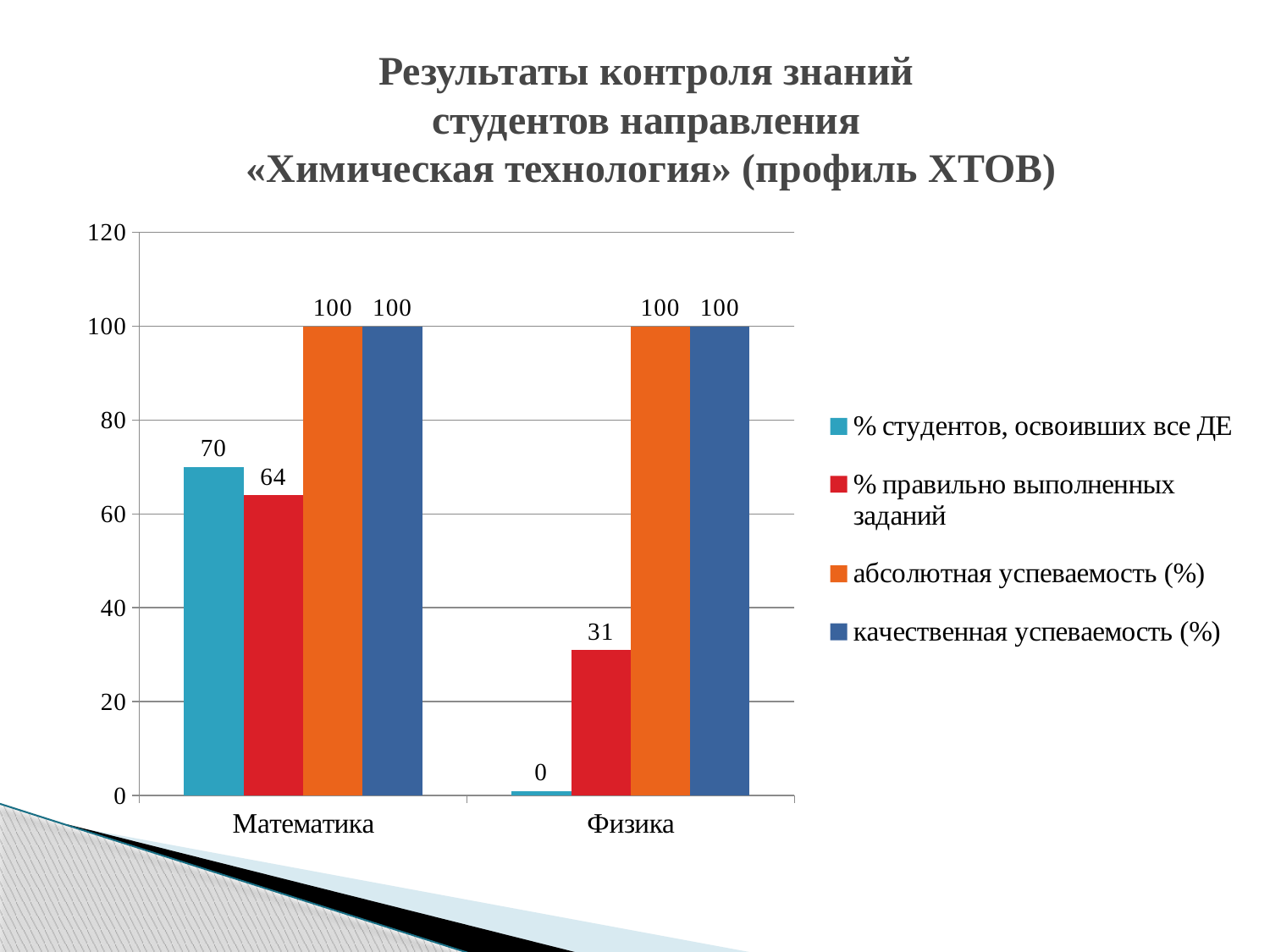
What is the value of "абсолютная успеваемость (%)" for Математика? 100 What is the value of "% правильно выполненных заданий" for Физика? 31 Which category has the higher value for "% студентов, освоивших все ДЕ", Математика or Физика? Математика Which series has the lowest value for Математика? % правильно выполненных заданий How many series does the legend list? 4 What is the difference between "% правильно выполненных заданий" for Математика and for Физика? 33 What colour are the bars for "качественная успеваемость (%)"? blue What is the value of "% студентов, освоивших все ДЕ" for Физика? 0 What is the difference between "% студентов, освоивших все ДЕ" and "% правильно выполненных заданий" for Математика? 6 What kind of chart is shown on the slide? bar chart How many categories are shown on the x axis? 2 What is the value of "% студентов, освоивших все ДЕ" for Математика? 70